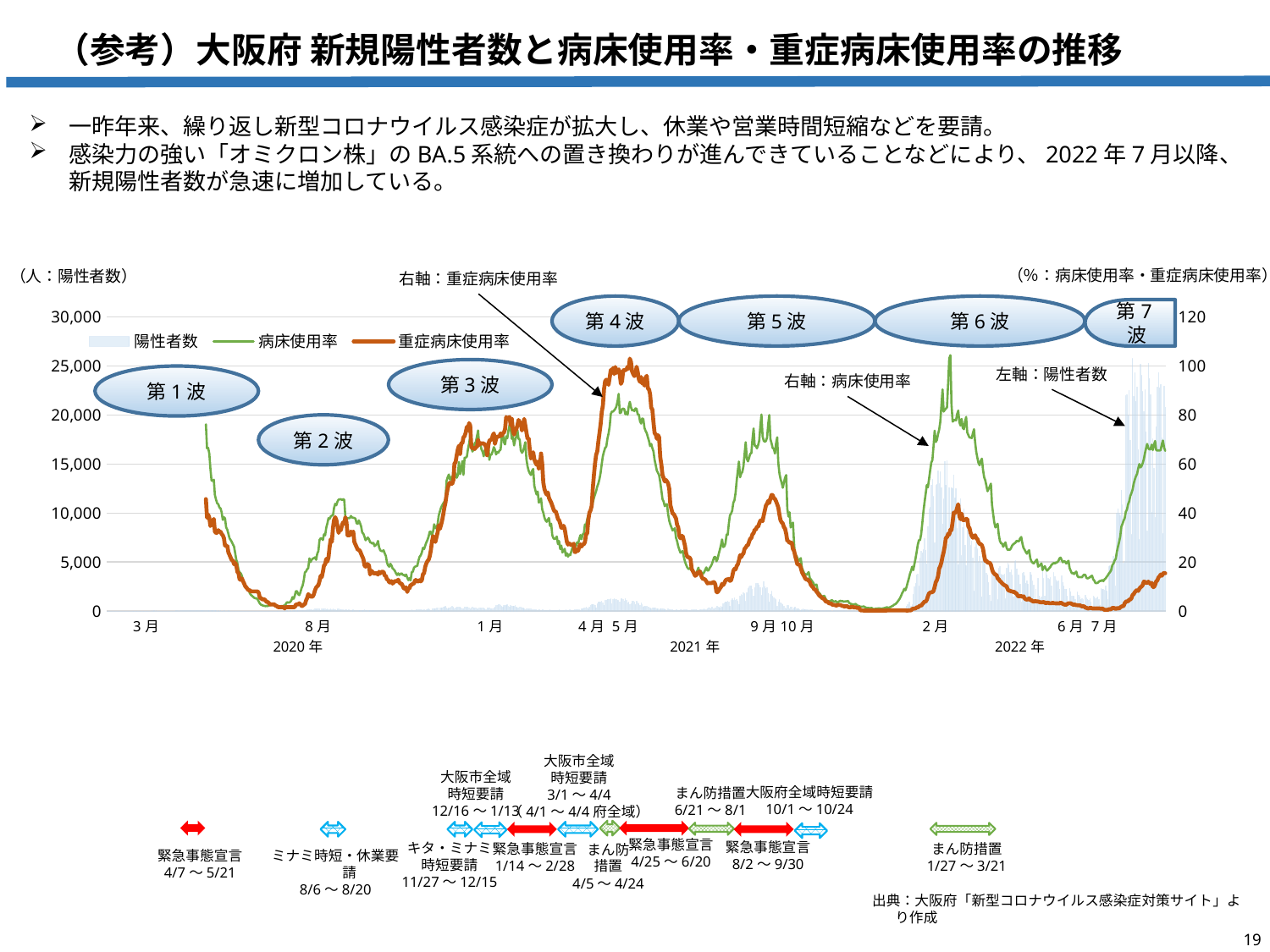
Is the peak of the 陽性者数 bars during 第7波 greater or less than 20,000? greater During 第6波, which line reaches a higher peak: 病床使用率 or 重症病床使用率? 病床使用率 What is the maximum value shown on the right axis of the chart? 120 In which wave do the 陽性者数 bars reach their highest level? 第7波 From 6月 2022 to 7月 2022, does the 病床使用率 line rise or fall? rise Is the peak value of 重症病床使用率 during 第5波 greater or less than 60? less What are the three series named in the chart legend? 陽性者数, 病床使用率, 重症病床使用率 How many series does the chart legend list? 3 What is the maximum value shown on the left axis of the chart? 30,000 Is the peak value of 病床使用率 during 第6波 greater or less than 100? greater What kind of chart is used to show 陽性者数 in the chart? bar chart During 第4波, which line reaches a higher peak: 病床使用率 or 重症病床使用率? 重症病床使用率